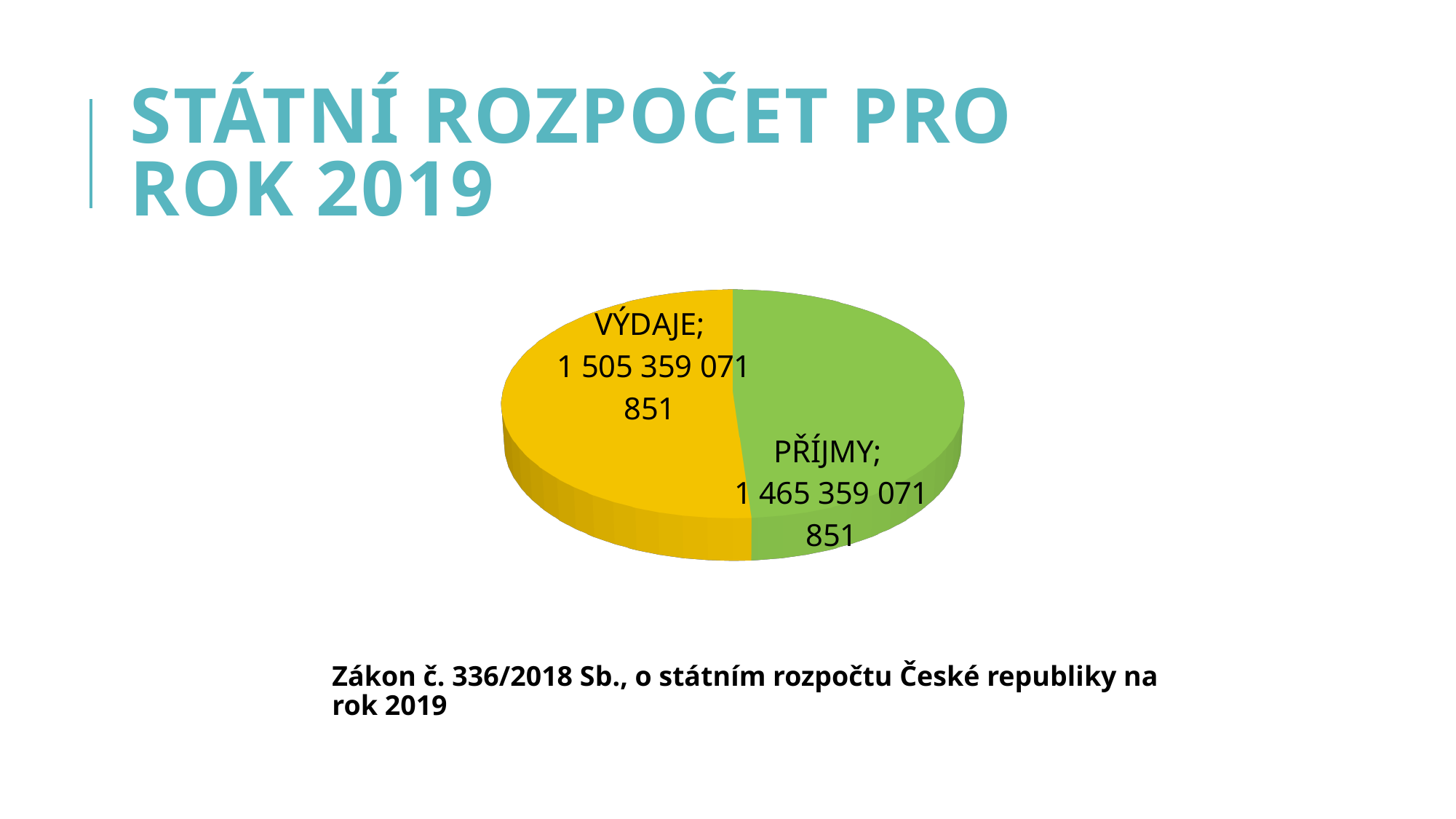
Which slice of the pie chart has the larger value, VÝDAJE or PŘÍJMY? VÝDAJE What is the total of the two values shown in the pie chart? 2 970 718 143 702 What is the value shown for VÝDAJE in the pie chart? 1 505 359 071 851 What is the difference between the VÝDAJE value and the PŘÍJMY value in the pie chart? 40 000 000 000 Which category in the pie chart has the largest value? VÝDAJE What kind of chart is shown on the slide? Pie chart What colour is the VÝDAJE slice in the pie chart? Yellow What is the value shown for PŘÍJMY in the pie chart? 1 465 359 071 851 What colour is the PŘÍJMY slice in the pie chart? Green How many slices does the pie chart have? 2 Which category in the pie chart has the smallest value? PŘÍJMY